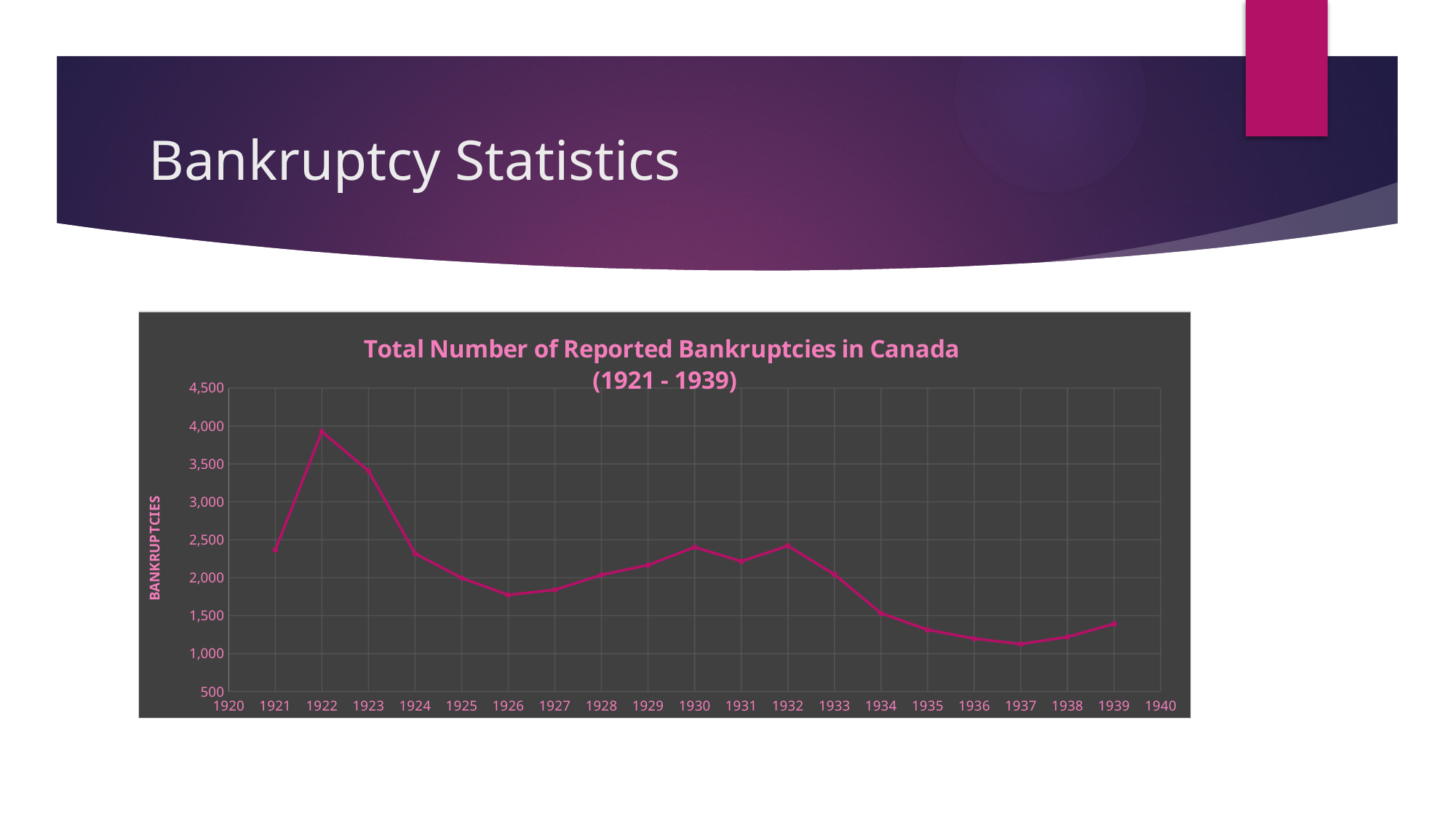
What kind of chart is shown on the slide? line chart Is the value for 1926 greater or less than 2,000? less Which year has the highest number of reported bankruptcies? 1922 Is the value for 1922 greater or less than 3,500? greater Which year has the lowest number of reported bankruptcies? 1937 Do the values rise or fall from 1932 to 1937? fall What is the title of the vertical axis? BANKRUPTCIES Is the value for 1935 greater or less than 1,500? less Which year has more reported bankruptcies, 1929 or 1936? 1929 Which year has more reported bankruptcies, 1922 or 1923? 1922 How many years are plotted on the chart? 19